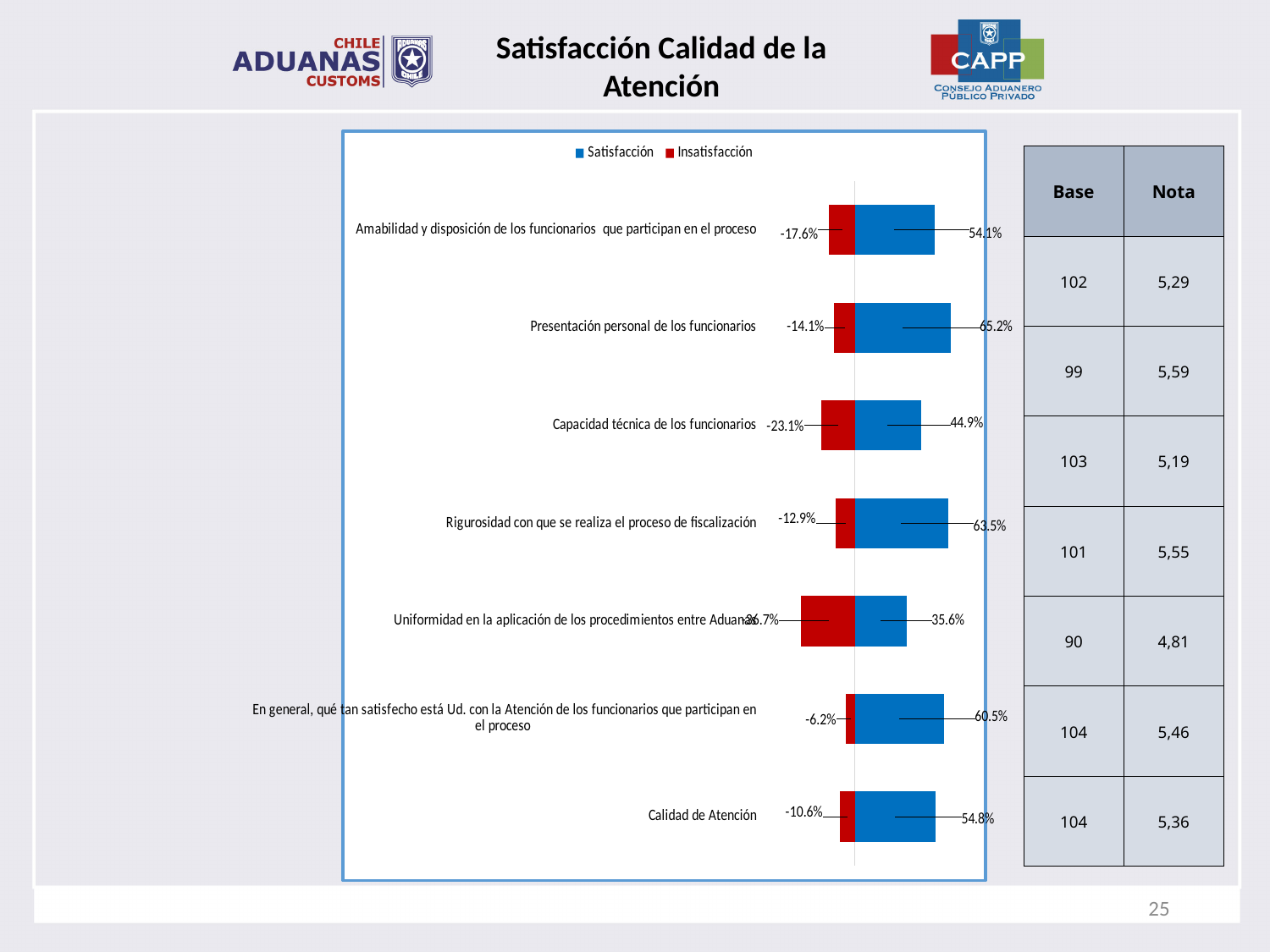
Which has a larger Satisfacción value: Amabilidad y disposición de los funcionarios que participan en el proceso or Rigurosidad con que se realiza el proceso de fiscalización? Rigurosidad con que se realiza el proceso de fiscalización What kind of chart is shown on the slide? Bar chart Which category has the lowest Satisfacción value? Uniformidad en la aplicación de los procedimientos entre Aduanas What is the Insatisfacción value for Capacidad técnica de los funcionarios? -23.1% What is the Satisfacción value for Presentación personal de los funcionarios? 65.2% How many categories are shown in the chart? 7 How many series does the legend list? 2 What is the Satisfacción value for Calidad de Atención? 54.8% Which category has the highest Satisfacción value? Presentación personal de los funcionarios What is the Insatisfacción value for Rigurosidad con que se realiza el proceso de fiscalización? -12.9% Which colour represents Insatisfacción in the chart? Red What is the difference between the Satisfacción values for Presentación personal de los funcionarios and Capacidad técnica de los funcionarios? 20.3%